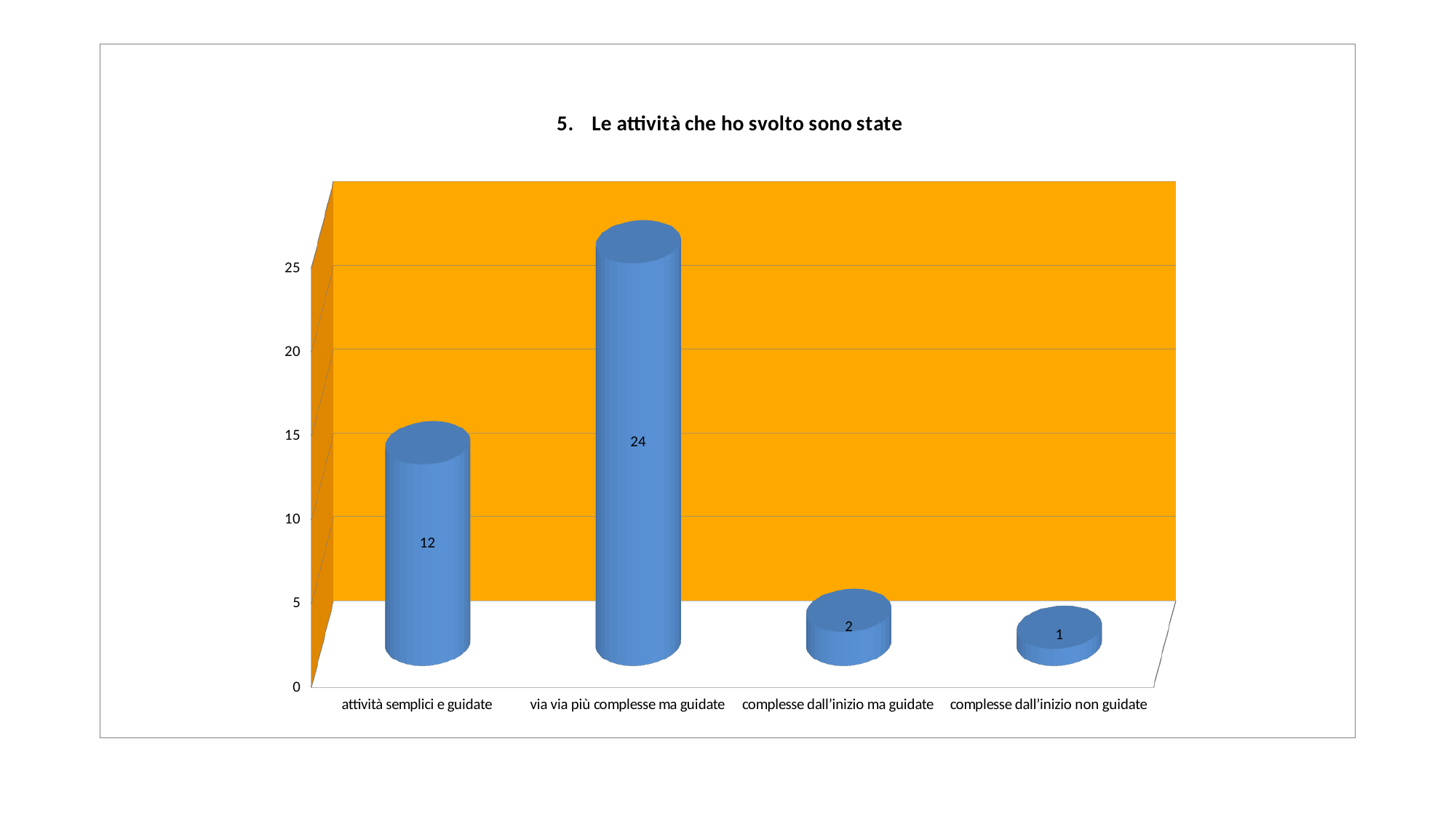
What kind of chart is shown on the slide? bar chart Which category has the highest value? via via più complesse ma guidate How many categories are shown on the x axis? 4 What is the value for 'via via più complesse ma guidate'? 24 Which category has the lowest value? complesse dall'inizio non guidate What is the value for 'complesse dall'inizio non guidate'? 1 What is the title of the chart? 5. Le attività che ho svolto sono state Which is larger: the value for 'attività semplici e guidate' or the value for 'complesse dall'inizio ma guidate'? attività semplici e guidate What is the value for 'attività semplici e guidate'? 12 Is the value for 'via via più complesse ma guidate' greater or less than 20? greater What is the difference between the values for 'via via più complesse ma guidate' and 'attività semplici e guidate'? 12 What is the value for 'complesse dall'inizio ma guidate'? 2